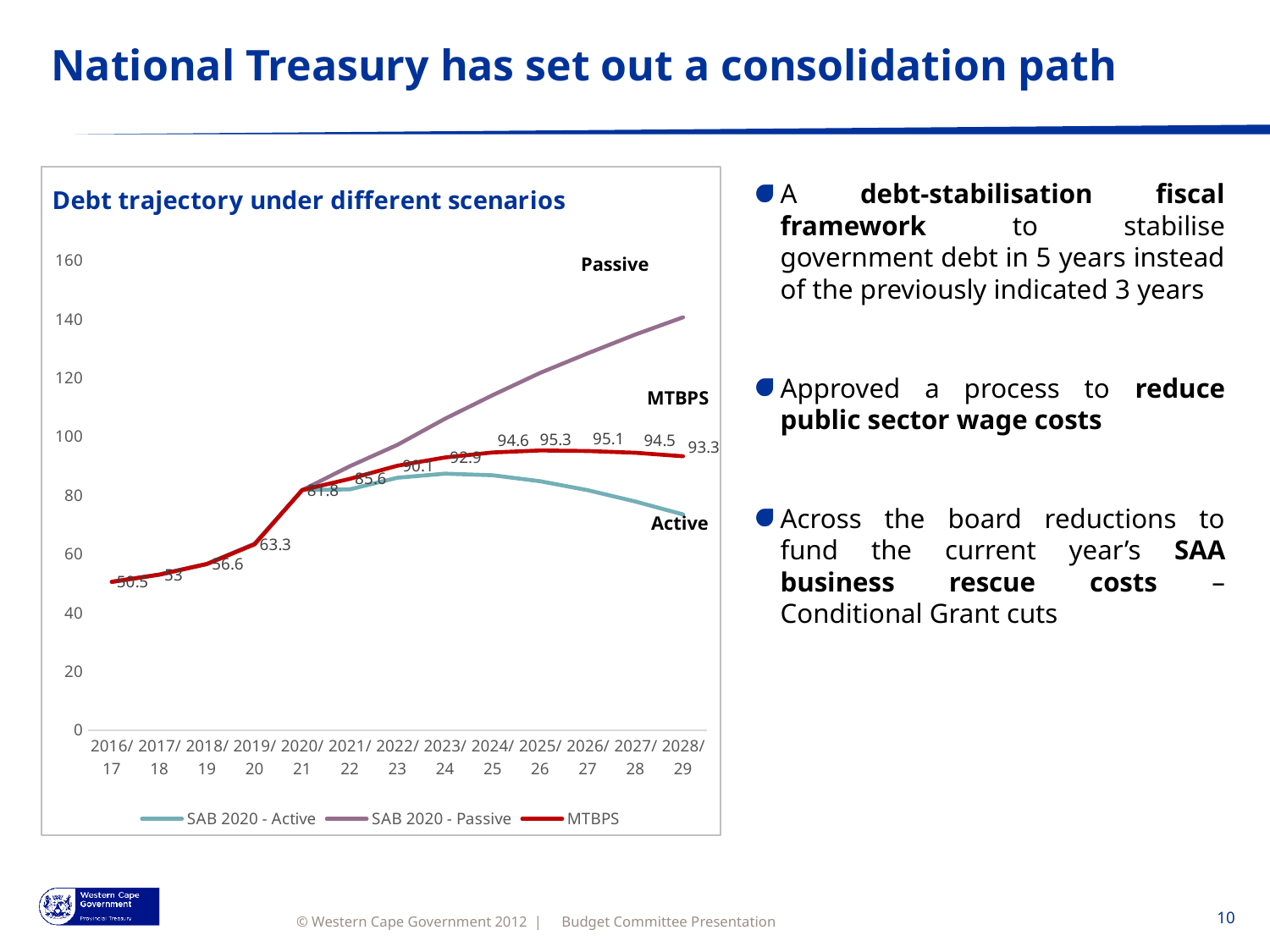
What is the title of the chart? Debt trajectory under different scenarios In which year does the MTBPS series reach its highest value? 2025/26 How many fiscal years are shown on the x axis? 13 Which series has the highest value in 2028/29? SAB 2020 - Passive What is the MTBPS value for 2025/26? 95.3 What is the MTBPS value for 2019/20? 63.3 What is the MTBPS value for 2028/29? 93.3 What is the difference between the MTBPS values for 2020/21 and 2019/20? 18.5 What kind of chart is shown on the slide? line chart Is the SAB 2020 - Passive value for 2028/29 greater or less than 120? greater In which year is the MTBPS series at its lowest value? 2016/17 How many series does the legend list? 3